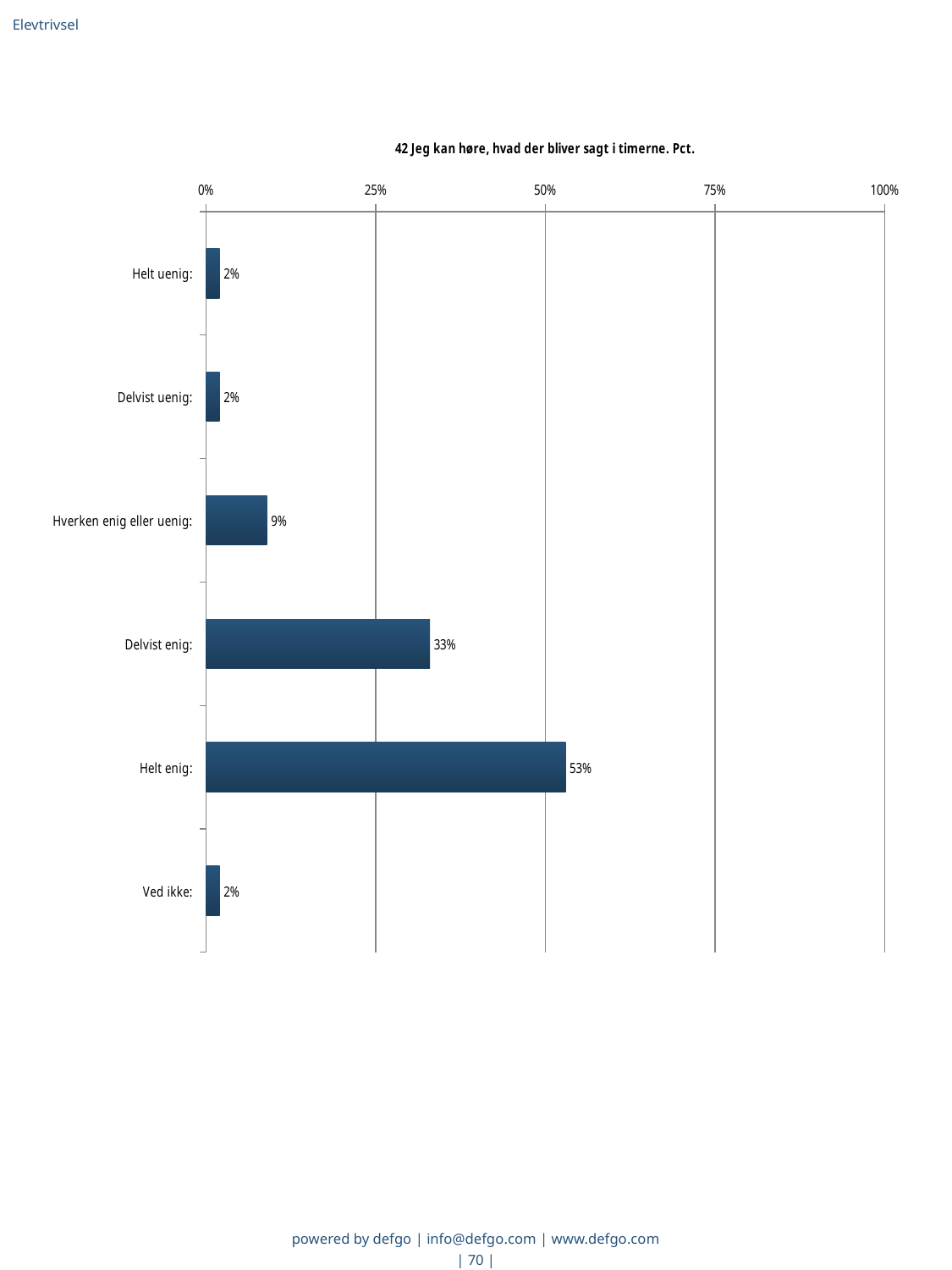
What is the title of the chart? 42 Jeg kan høre, hvad der bliver sagt i timerne. Pct. Is the value for "Helt enig" greater or less than 50%? greater What is the difference between the values for "Helt enig" and "Delvist enig"? 20% How many categories are shown in the chart? 6 Which category has the highest value? Helt enig What kind of chart is shown on the slide? Bar chart What is the value for "Hverken enig eller uenig"? 9% What is the value for "Helt enig"? 53% What is the value for "Delvist enig"? 33% What is the value for "Ved ikke"? 2% Which is larger, the value for "Delvist enig" or the value for "Hverken enig eller uenig"? Delvist enig What is the difference between the values for "Delvist enig" and "Hverken enig eller uenig"? 24%